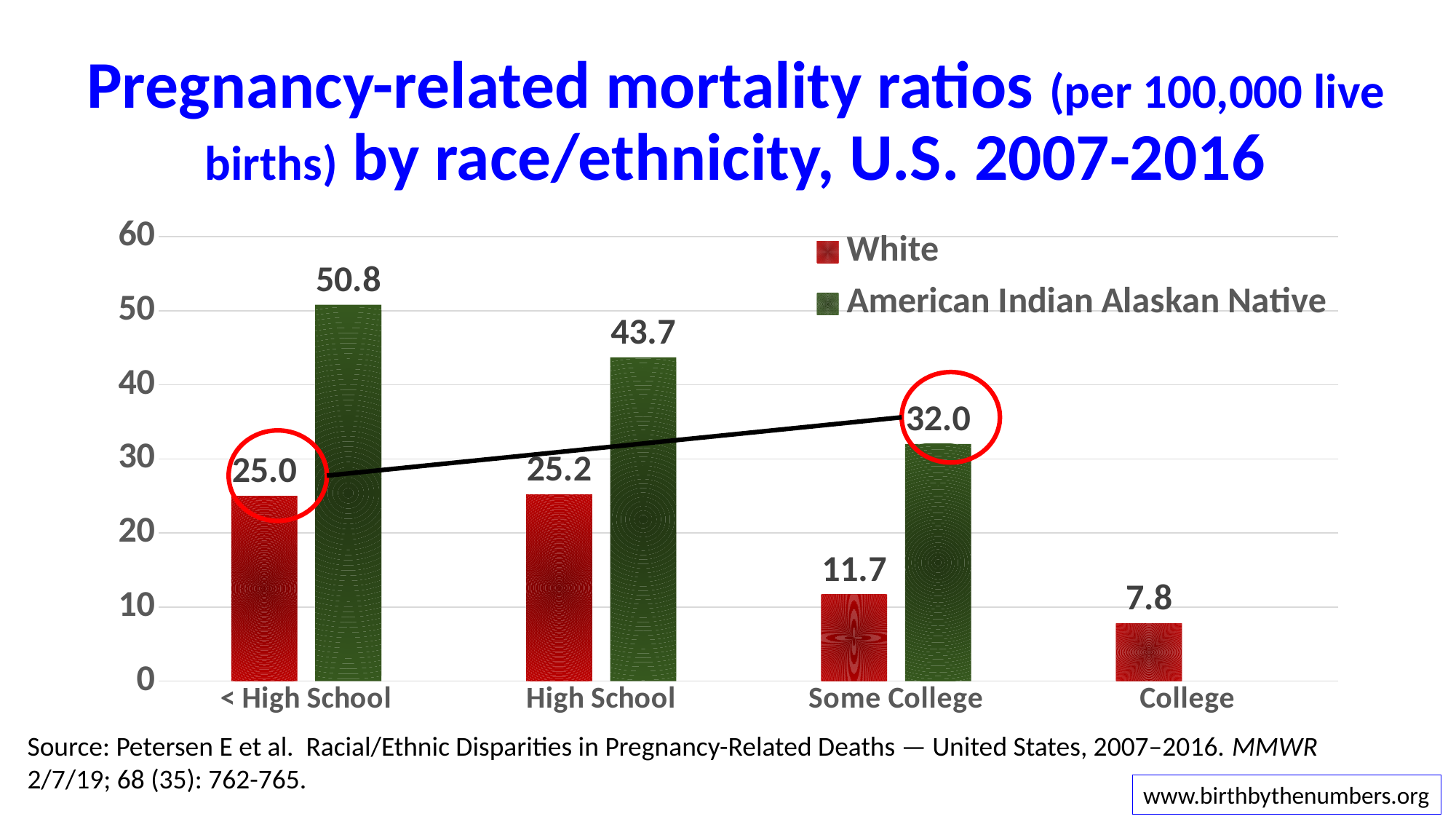
What is the difference between the American Indian Alaskan Native and White values in the < High School category? 25.8 What is the value for White women in the College category? 7.8 Which education category has the highest value for American Indian Alaskan Native women? < High School How many series does the legend list? 2 What is the pregnancy-related mortality ratio for American Indian Alaskan Native women with a high school education? 43.7 What is the pregnancy-related mortality ratio for White women with less than a high school education? 25.0 Which is larger in the Some College category: the White value or the American Indian Alaskan Native value? American Indian Alaskan Native What is the difference between the American Indian Alaskan Native and White values in the Some College category? 20.3 Which colour represents the White series in the chart? Red Which education category has the lowest value for White women? College How many education categories are shown on the x axis? 4 What kind of chart is shown on the slide? Bar chart